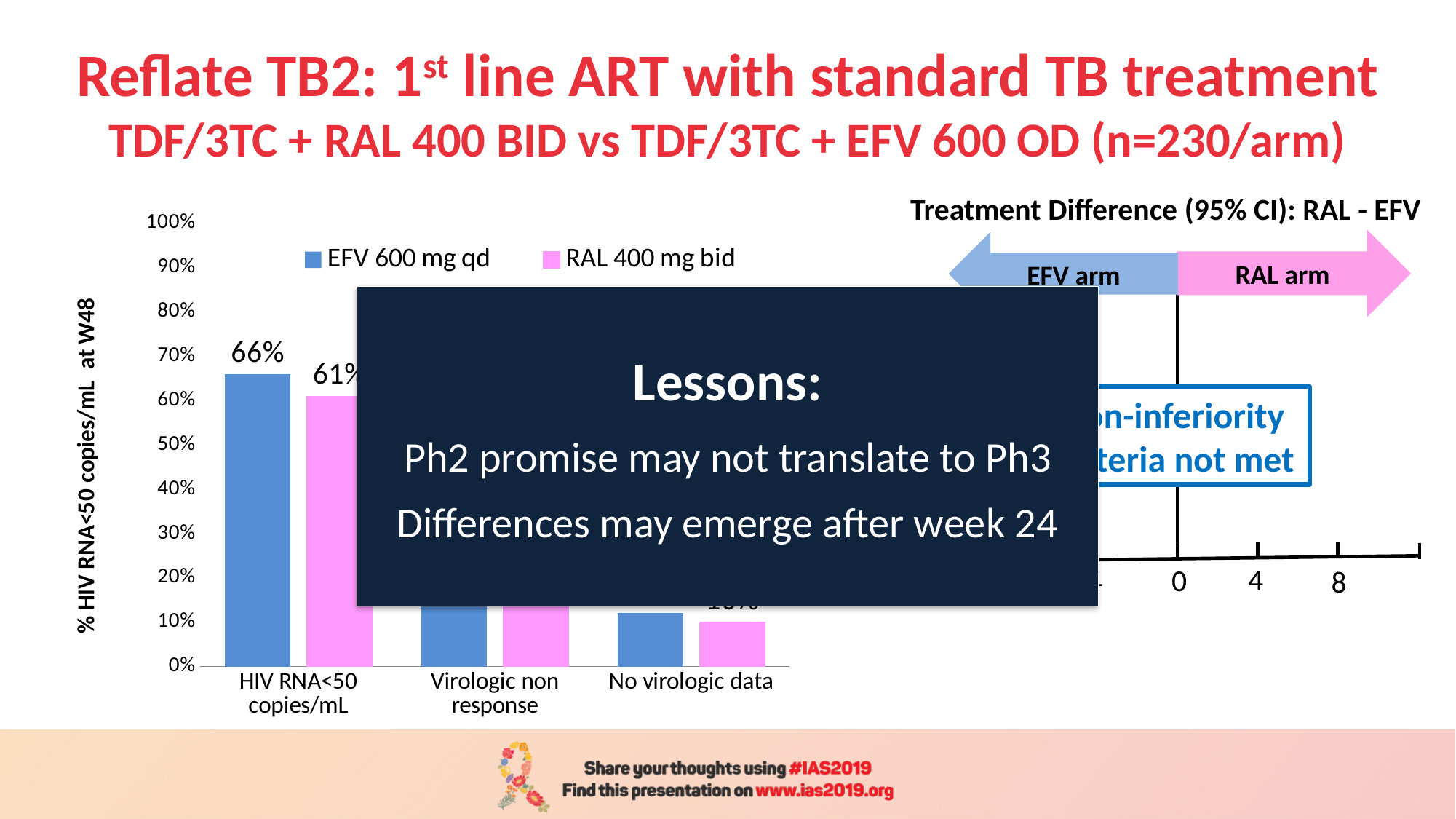
In the bar chart on the left, which bar is the highest overall? EFV 600 mg qd, HIV RNA<50 copies/mL What is the y-axis label of the bar chart on the left? % HIV RNA<50 copies/mL at W48 How many categories are shown on the x axis of the bar chart on the left? 3 In the bar chart on the left, what is the difference between the EFV 600 mg qd and RAL 400 mg bid values for HIV RNA<50 copies/mL? 5 percentage points In the bar chart on the left, is the value for EFV 600 mg qd in the No virologic data category greater or less than 20%? less What kind of chart is the chart on the left of the slide? Bar chart In the bar chart on the left, is the value for RAL 400 mg bid in the HIV RNA<50 copies/mL category greater or less than 50%? greater In the bar chart on the left, is the value for RAL 400 mg bid in the No virologic data category greater or less than 20%? less In the bar chart on the left, what is the value for RAL 400 mg bid in the HIV RNA<50 copies/mL category? 61% How many series does the legend of the bar chart on the left list? 2 In the bar chart on the left, which series has the larger value for HIV RNA<50 copies/mL, EFV 600 mg qd or RAL 400 mg bid? EFV 600 mg qd In the bar chart on the left, what is the value for EFV 600 mg qd in the HIV RNA<50 copies/mL category? 66%